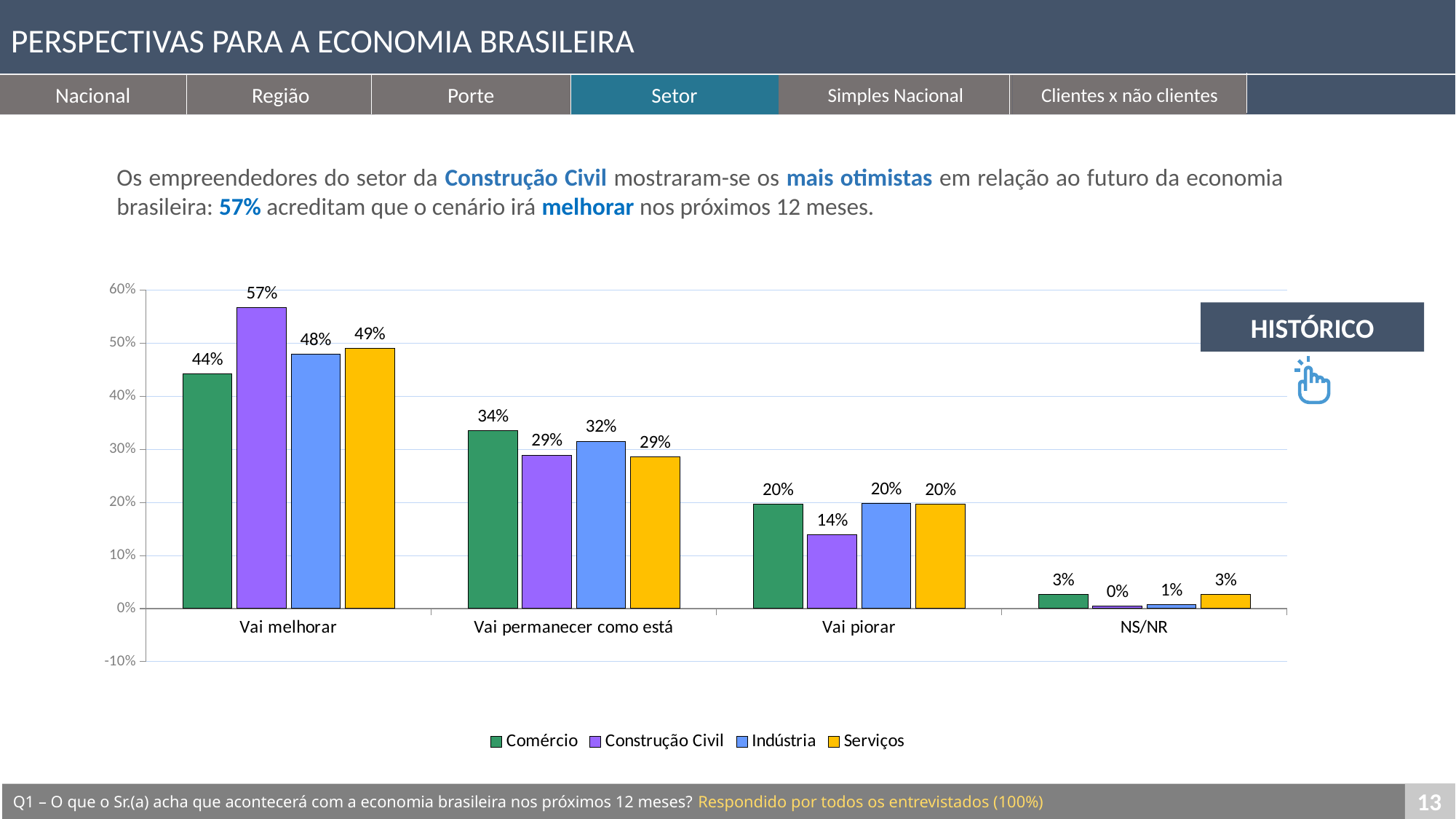
How many categories are shown on the x axis? 4 What is the value for Construção Civil in the 'Vai melhorar' category? 57% Which series has the highest value in the 'Vai melhorar' category? Construção Civil How many series does the legend list? 4 Which series has the lowest value in the 'Vai piorar' category? Construção Civil Which colour represents Serviços in the chart? Yellow Is the value for Construção Civil in 'Vai melhorar' greater or less than 50%? greater What is the difference between Serviços and Comércio in the 'Vai melhorar' category? 5% What is the value for Comércio in the 'Vai permanecer como está' category? 34% What kind of chart is shown on the slide? Bar chart What is the value for Indústria in the 'NS/NR' category? 1% In the 'Vai permanecer como está' category, which is larger: Comércio or Indústria? Comércio